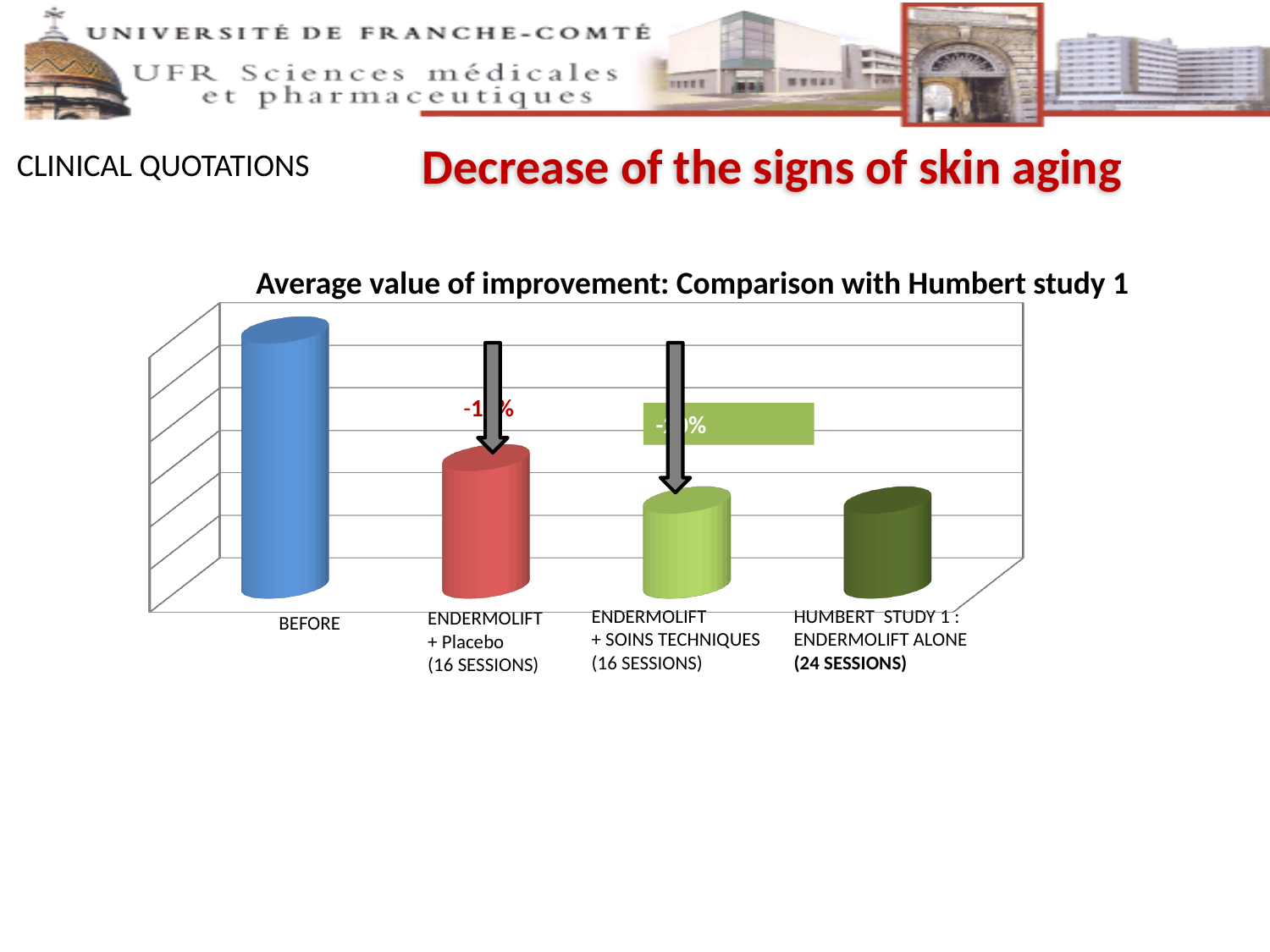
Which category is labelled with 24 SESSIONS? HUMBERT STUDY 1 : ENDERMOLIFT ALONE Which bar is taller: ENDERMOLIFT + Placebo (16 SESSIONS) or ENDERMOLIFT + SOINS TECHNIQUES (16 SESSIONS)? ENDERMOLIFT + Placebo (16 SESSIONS) What kind of chart is shown on the slide? Bar chart Do the bar values generally rise or fall from left to right across the chart? Fall How many categories are plotted in the chart? 4 What is the title of the chart? Average value of improvement: Comparison with Humbert study 1 What colour is the BEFORE bar in the chart? Blue Which category has the highest bar in the chart? BEFORE Which bar is taller: BEFORE or ENDERMOLIFT + Placebo (16 SESSIONS)? BEFORE